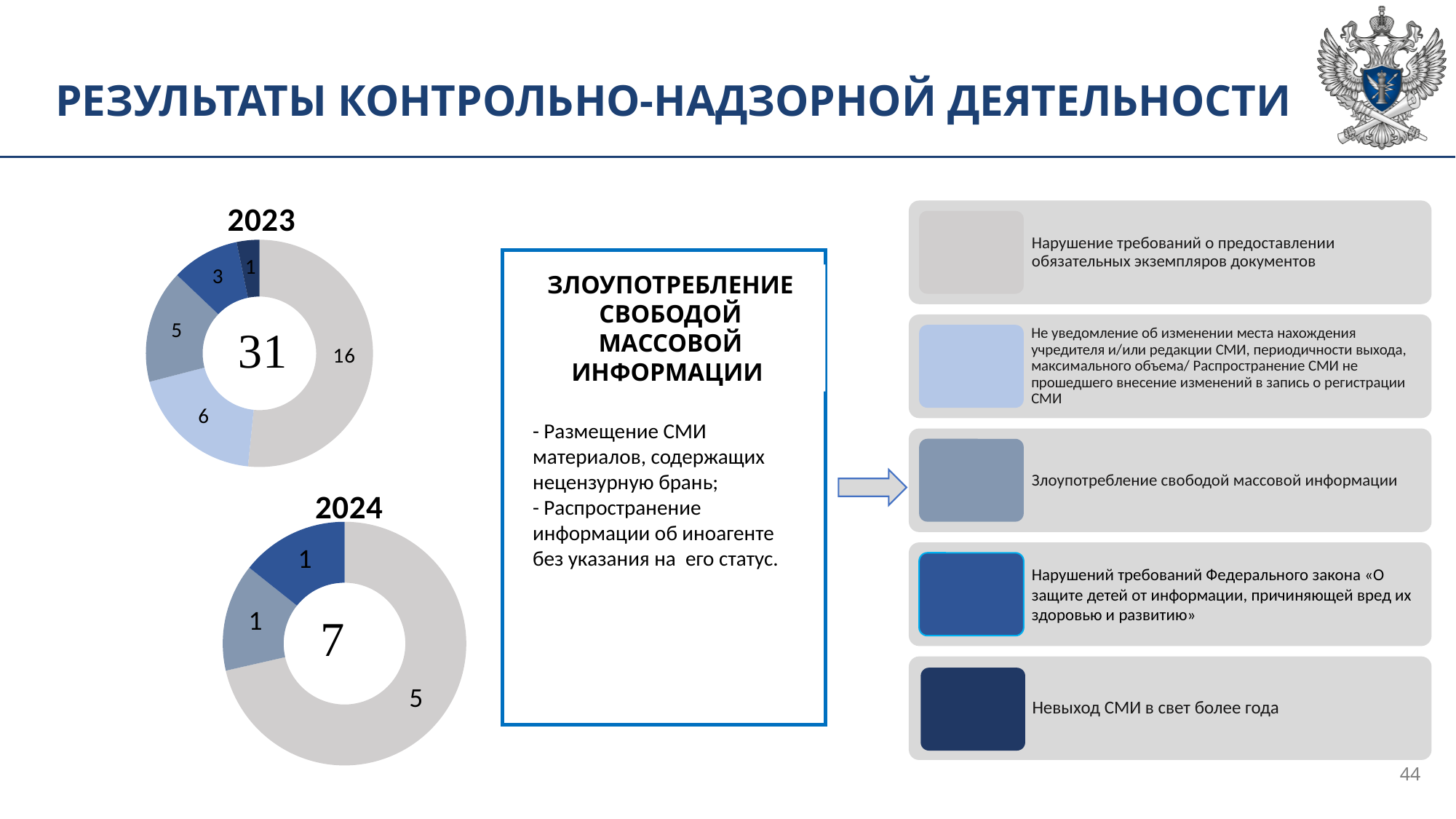
How many slices does the 2024 chart have? 3 According to the legend on the right, which category does the darkest navy colour represent? Невыход СМИ в свет более года In the 2024 chart, what is the value of the largest slice? 5 In the 2023 chart, what is the value of the largest slice? 16 What total is shown in the centre of the 2023 chart? 31 In the 2023 chart, what is the difference between the largest slice (16) and the slice labelled 6? 10 In the 2023 chart, what is the value of the slice for 'Злоупотребление свободой массовой информации' (the blue-grey slice)? 5 In the 2023 chart, what is the value of the smallest slice? 1 What type of chart is used for the 2023 data? Donut (pie) chart Which chart has the larger total in its centre, 2023 or 2024? 2023 What total is shown in the centre of the 2024 chart? 7 How many slices does the 2023 chart have? 5